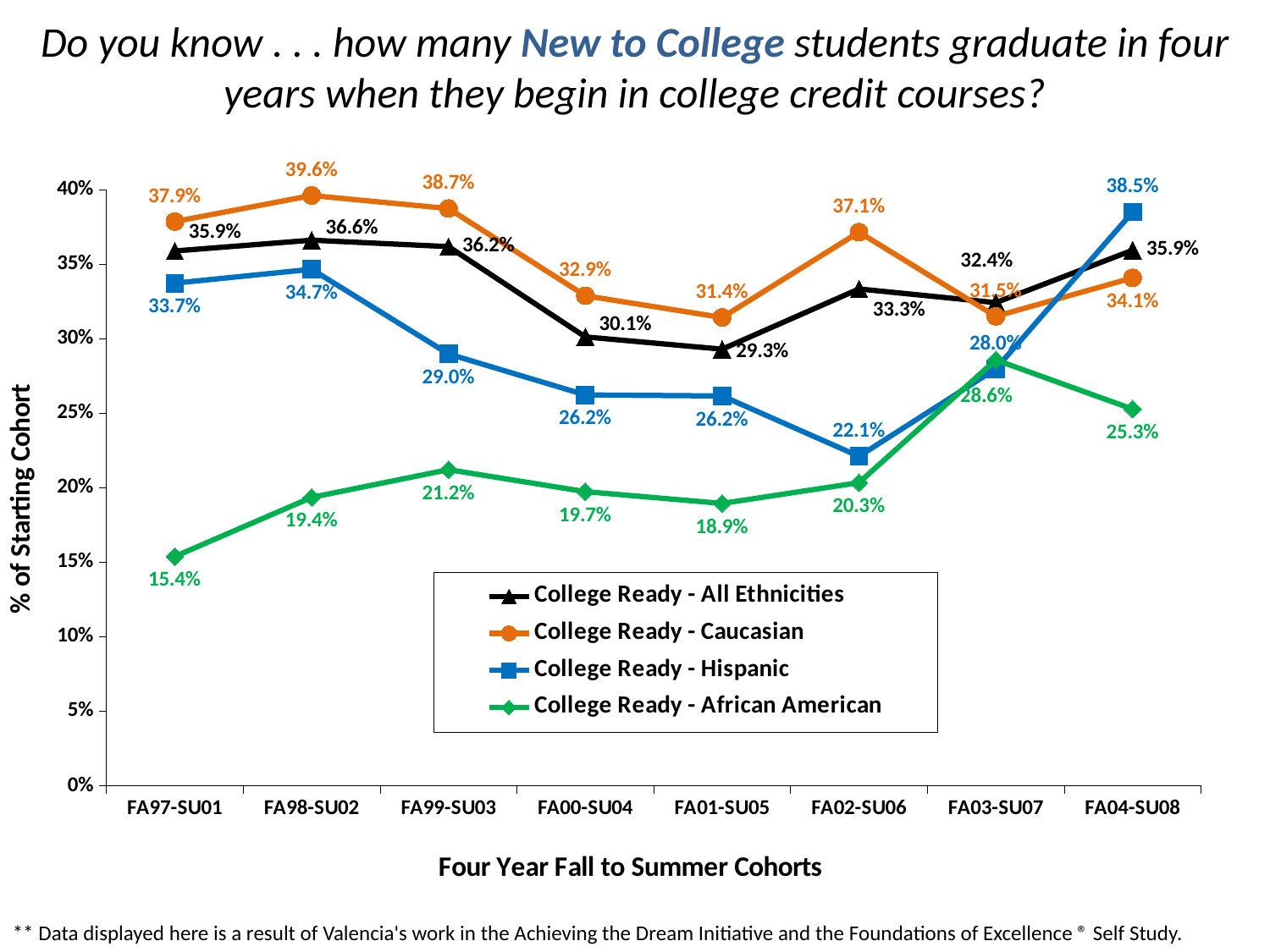
Which cohort has the lowest value for College Ready - Hispanic? FA02-SU06 Does the College Ready - African American line rise or fall from FA97-SU01 to FA99-SU03? rise How many cohorts are shown on the x axis? 8 In the FA04-SU08 cohort, which is larger: College Ready - Hispanic or College Ready - Caucasian? College Ready - Hispanic What is the value for College Ready - Hispanic in the FA04-SU08 cohort? 38.5% What is the value for College Ready - African American in the FA97-SU01 cohort? 15.4% What is the difference between College Ready - Caucasian and College Ready - All Ethnicities in the FA98-SU02 cohort? 3.0 percentage points Which cohort has the highest value for College Ready - Caucasian? FA98-SU02 How many series does the legend list? 4 Is the value for College Ready - Hispanic in the FA02-SU06 cohort greater or less than 25%? less What kind of chart is shown on the slide? line chart What is the value for College Ready - Caucasian in the FA98-SU02 cohort? 39.6%